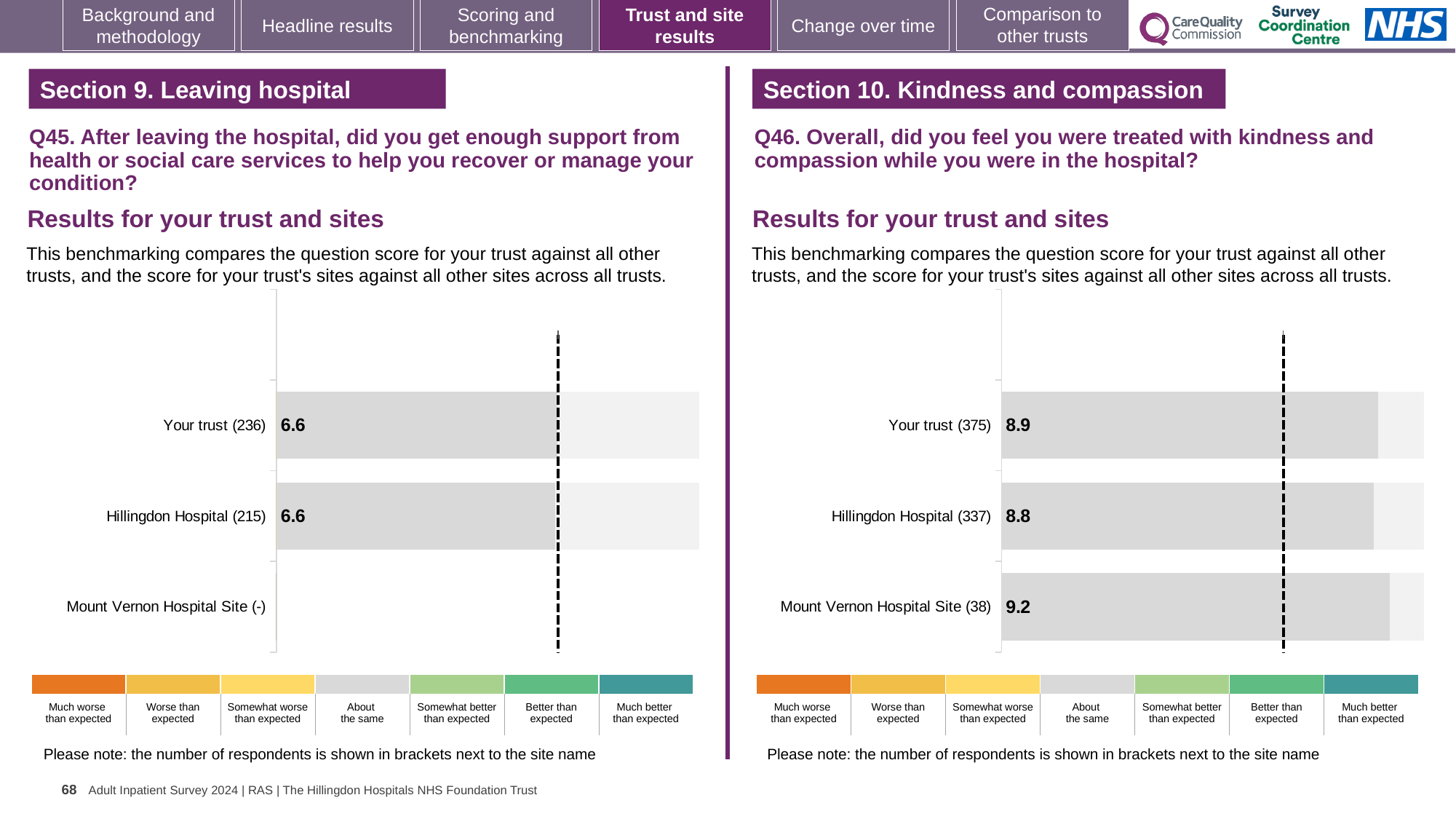
In the Q46 chart on the right, which site or trust has the lowest score? Hillingdon Hospital In the Q46 chart on the right, which site or trust has the highest score? Mount Vernon Hospital Site In the Q46 chart on the right, what is the difference between the Mount Vernon Hospital Site score and the Hillingdon Hospital score? 0.4 What kind of chart is the Q46 chart on the right? Bar chart In the Q46 chart on the right, what is the score for Your trust? 8.9 How many categories (trust and sites) are listed in the Q45 chart on the left? 3 In the Q46 chart on the right, what is the score for Hillingdon Hospital? 8.8 In the Q45 chart on the left, what is the score for Hillingdon Hospital? 6.6 In the Q46 chart on the right, how many respondents are shown for Your trust? 375 In the Q45 chart on the left, what is the score for Your trust? 6.6 In the Q46 chart on the right, what is the score for Mount Vernon Hospital Site? 9.2 In the Q45 chart on the left, how many respondents are shown for Hillingdon Hospital? 215